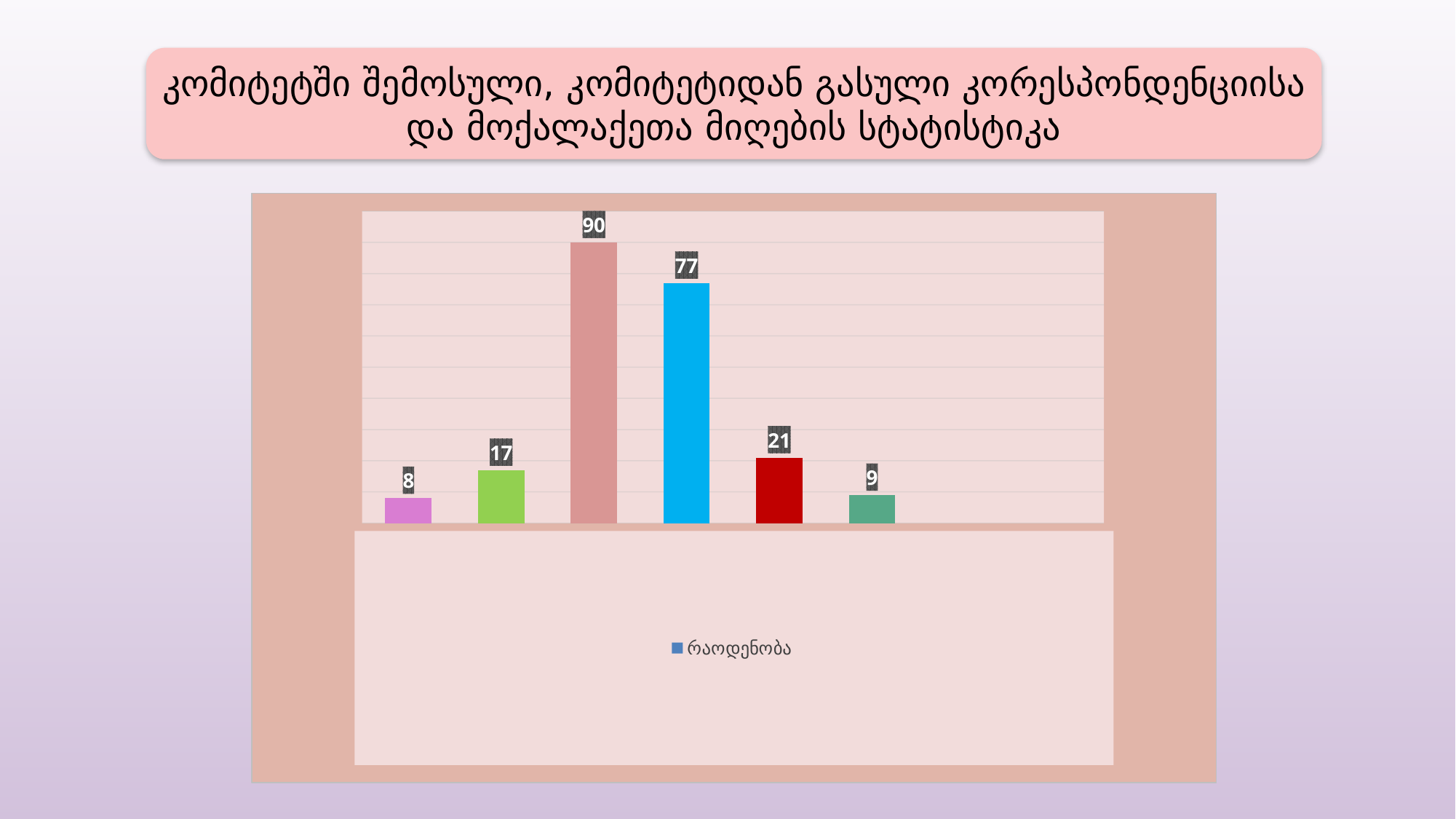
How many bars are plotted in the chart? 6 What is the value of the blue bar? 77 What is the value of the first (leftmost, magenta) bar? 8 What type of chart is shown on the slide? bar chart What is the difference between the green bar and the rightmost teal bar? 8 What is the value shown on the tallest bar? 90 What is the name of the series shown in the legend? რაოდენობა What is the value shown on the shortest bar? 8 How many series does the chart legend list? 1 What is the value of the dark red bar? 21 Which is larger, the green bar or the dark red bar? the dark red bar (21) What is the difference between the tallest bar (90) and the blue bar (77)? 13